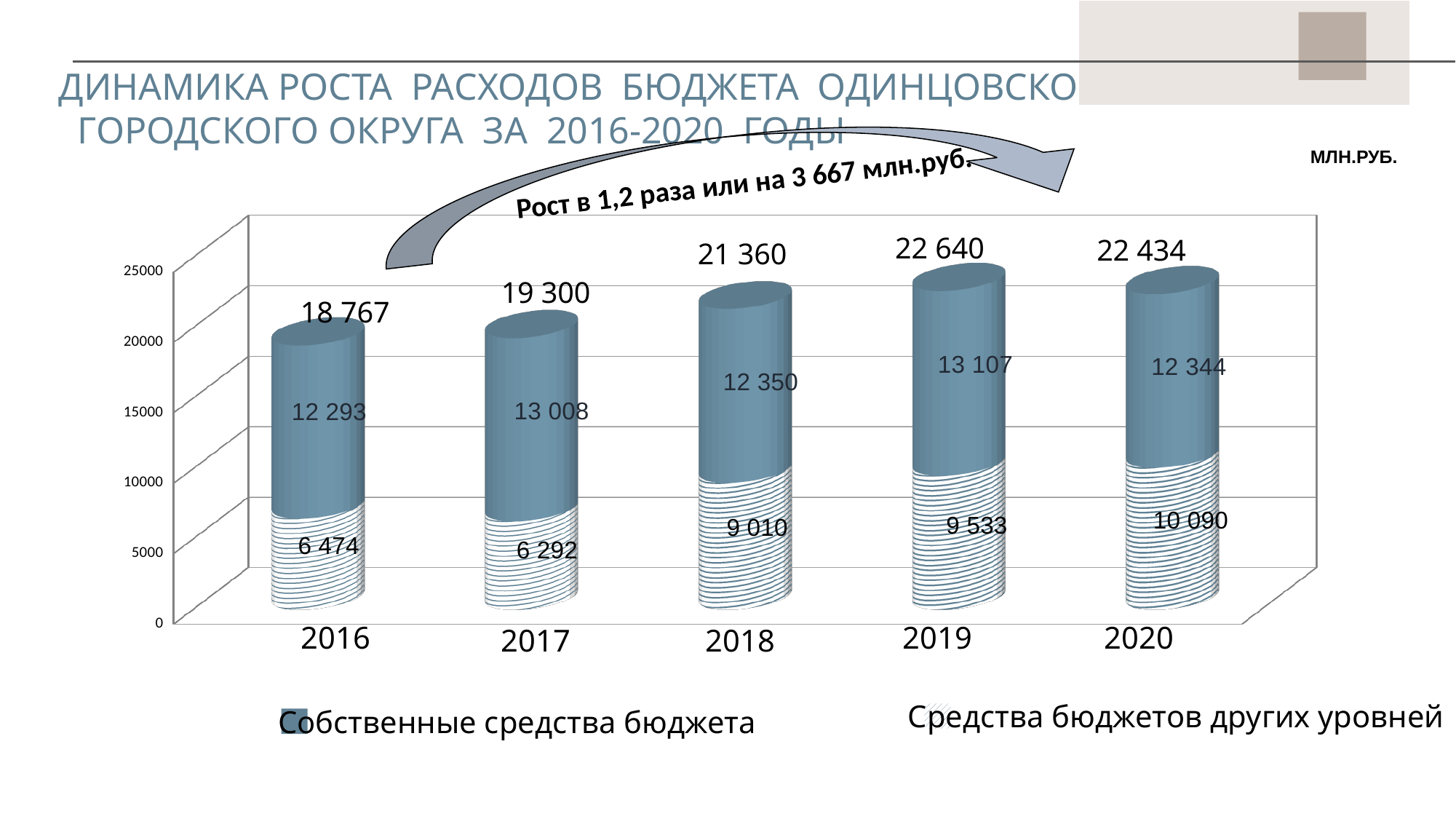
Which is larger: 'Собственные средства бюджета' in 2018 or 'Средства бюджетов других уровней' in 2018? Собственные средства бюджета How many series does the chart legend list? 2 Which year has the highest total budget expenditure? 2019 What unit of measurement is indicated in the top right corner of the chart? МЛН.РУБ. What is the difference between the total for 2020 and the total for 2016? 3 667 What is the value of 'Средства бюджетов других уровней' for 2017? 6 292 What is the value of 'Средства бюджетов других уровней' for 2020? 10 090 What is the total budget expenditure shown for 2016? 18 767 What is the value of 'Собственные средства бюджета' for 2019? 13 107 How many years are shown on the x axis of the chart? 5 Which year has the lowest value for 'Средства бюджетов других уровней'? 2017 What kind of chart is shown on the slide? bar chart